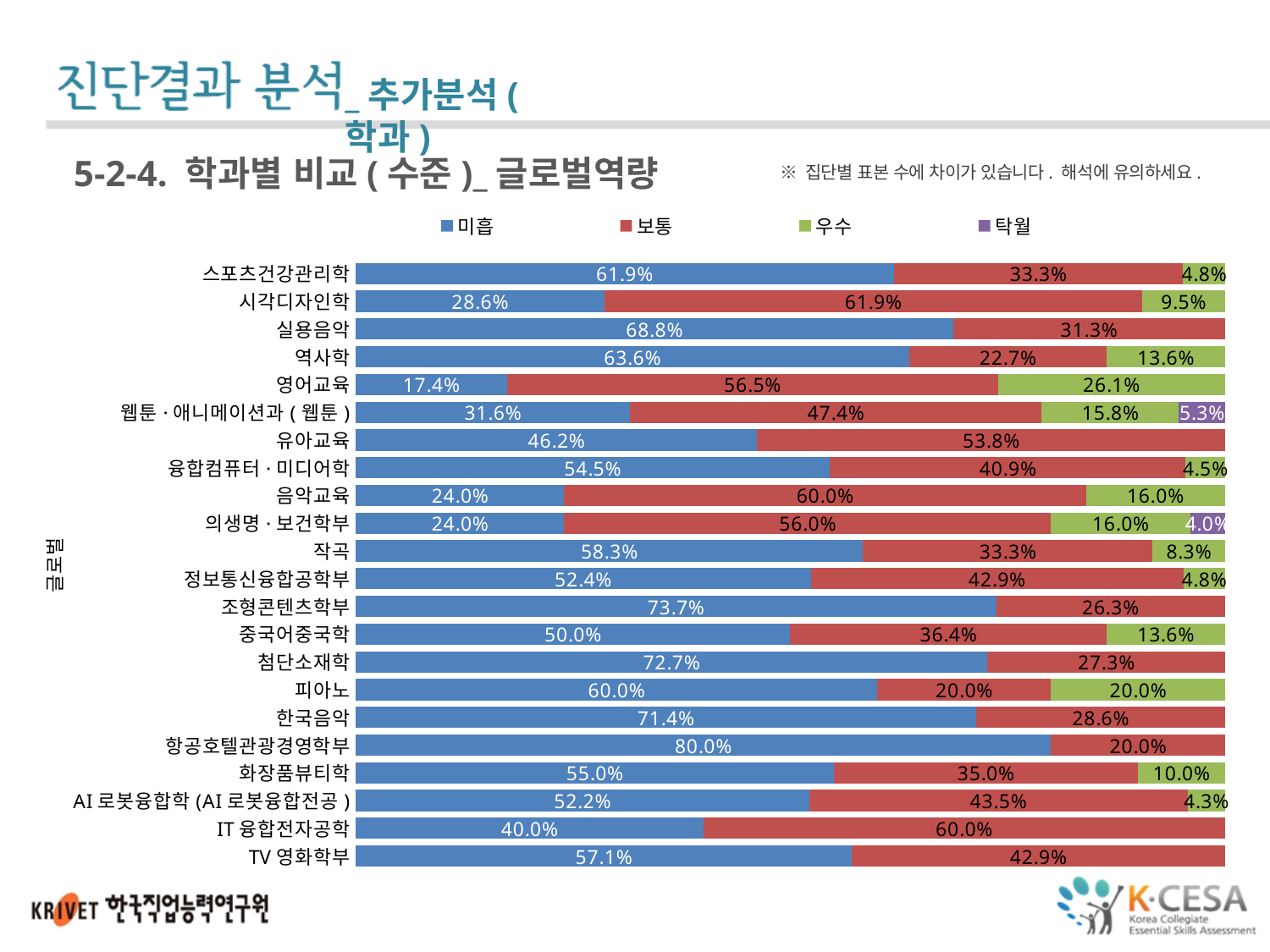
Which is larger: the 우수 value for 역사학 or the 우수 value for 작곡? 역사학 How many departments (categories) are plotted in the chart? 22 How many series does the legend list? 4 What kind of chart is shown on the slide? stacked bar chart What is the 탁월 value for 웹툰·애니메이션과(웹툰)? 5.3% Which legend entry is shown in green? 우수 Which department has the highest 미흡 value? 항공호텔관광경영학부 What is the difference between the 미흡 value for 조형콘텐츠학부 and the 미흡 value for 첨단소재학? 1.0% What is the 미흡 value for 항공호텔관광경영학부? 80.0% What is the total of the 미흡 and 보통 segments for 유아교육? 100.0% Which department has the lowest 미흡 value? 영어교육 What is the 보통 value for 영어교육? 56.5%